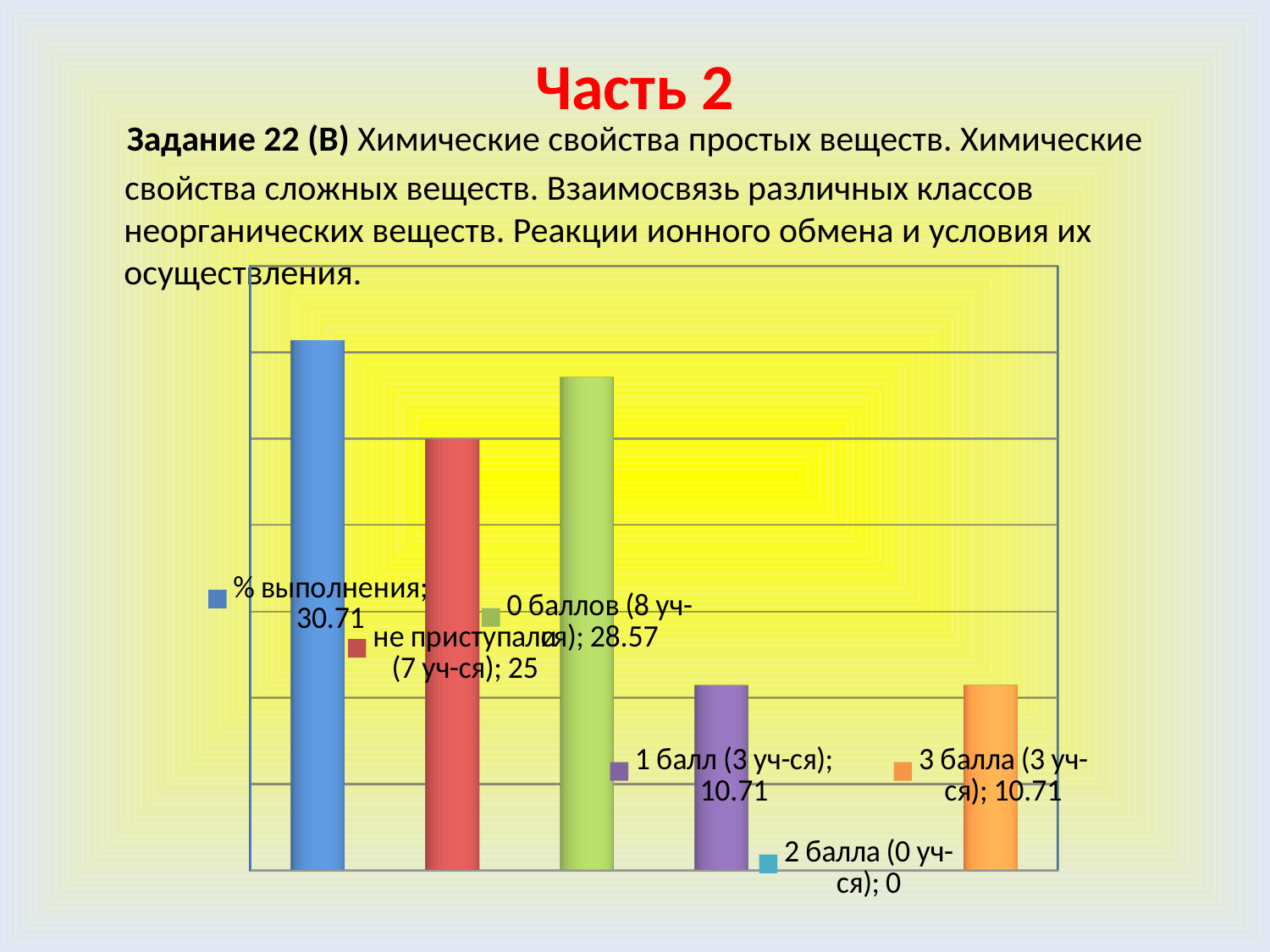
What is the difference between the values for "% выполнения" and "не приступали (7 уч-ся)"? 5.71 Which category has the highest value? % выполнения Which category has the lowest value? 2 балла (0 уч-ся) How many bars (categories) does the chart show? 6 What is the value labelled for "% выполнения"? 30.71 What kind of chart is shown on the slide? bar chart Which is larger, the value for "0 баллов (8 уч-ся)" or the value for "1 балл (3 уч-ся)"? 0 баллов (8 уч-ся) What is the value labelled for "2 балла (0 уч-ся)"? 0 What colour is the bar for "3 балла (3 уч-ся)"? orange What is the value labelled for "не приступали (7 уч-ся)"? 25 What is the value labelled for "1 балл (3 уч-ся)"? 10.71 What is the value labelled for "0 баллов (8 уч-ся)"? 28.57